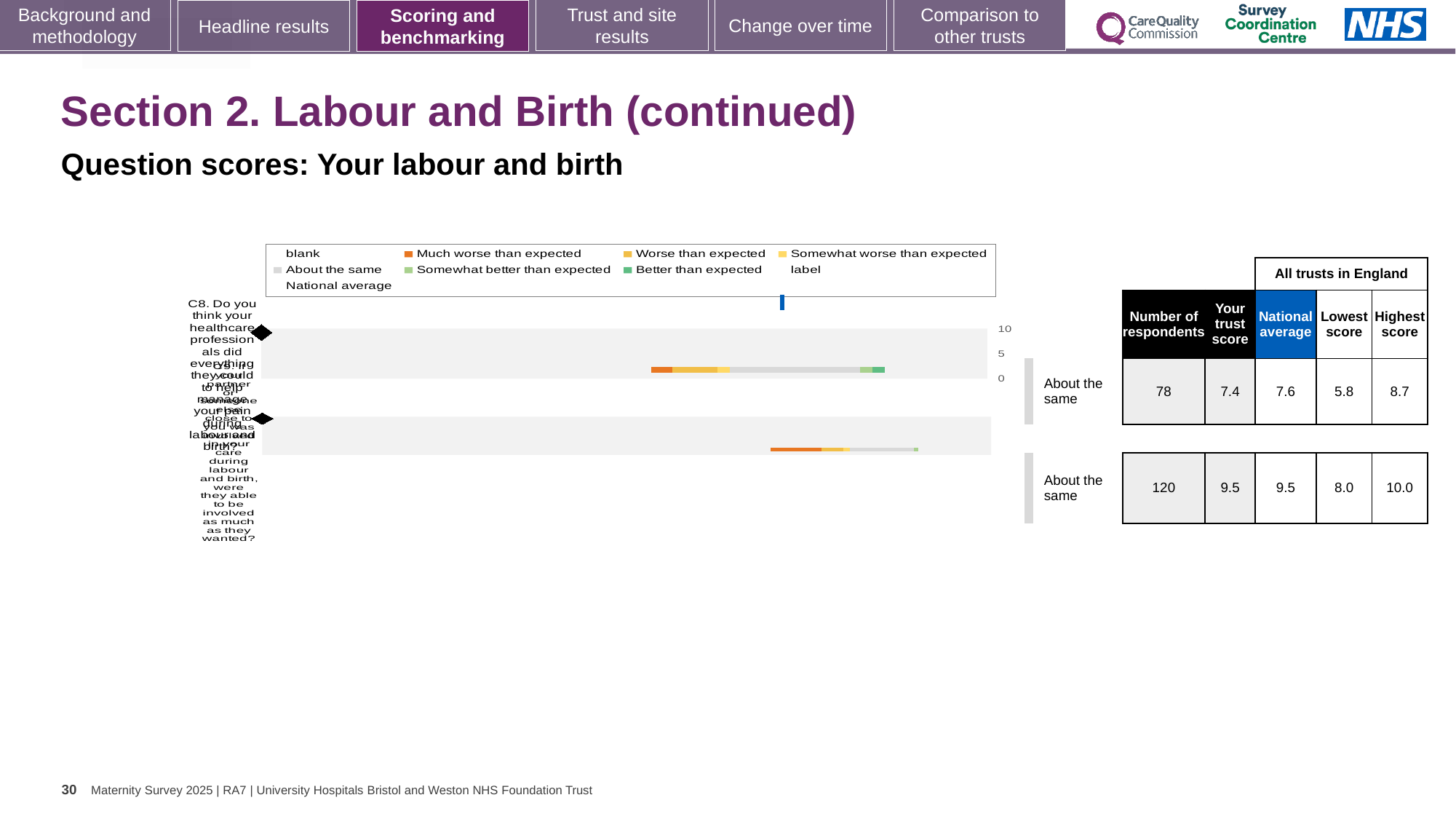
In the table beside the chart, what is the lowest score for the second question row? 8.0 What benchmark label is shown next to both question rows in the chart? About the same In the table beside the chart, what is the highest score for the second question row? 10.0 In the table beside the chart, what is the number of respondents for the second question row? 120 For the first question row, what is the difference between the highest score and the lowest score? 2.9 In the table beside the chart, what is the 'Your trust score' for the first question row? 7.4 How many question rows (bars) are plotted in the chart? 2 What kind of chart is shown on the slide? bar chart In the table beside the chart, what is the national average for the first question row? 7.6 For the first question row, which is larger: the trust score or the national average? national average In the chart legend, what colour represents 'Much worse than expected'? orange Which question row has more respondents, the first or the second? second